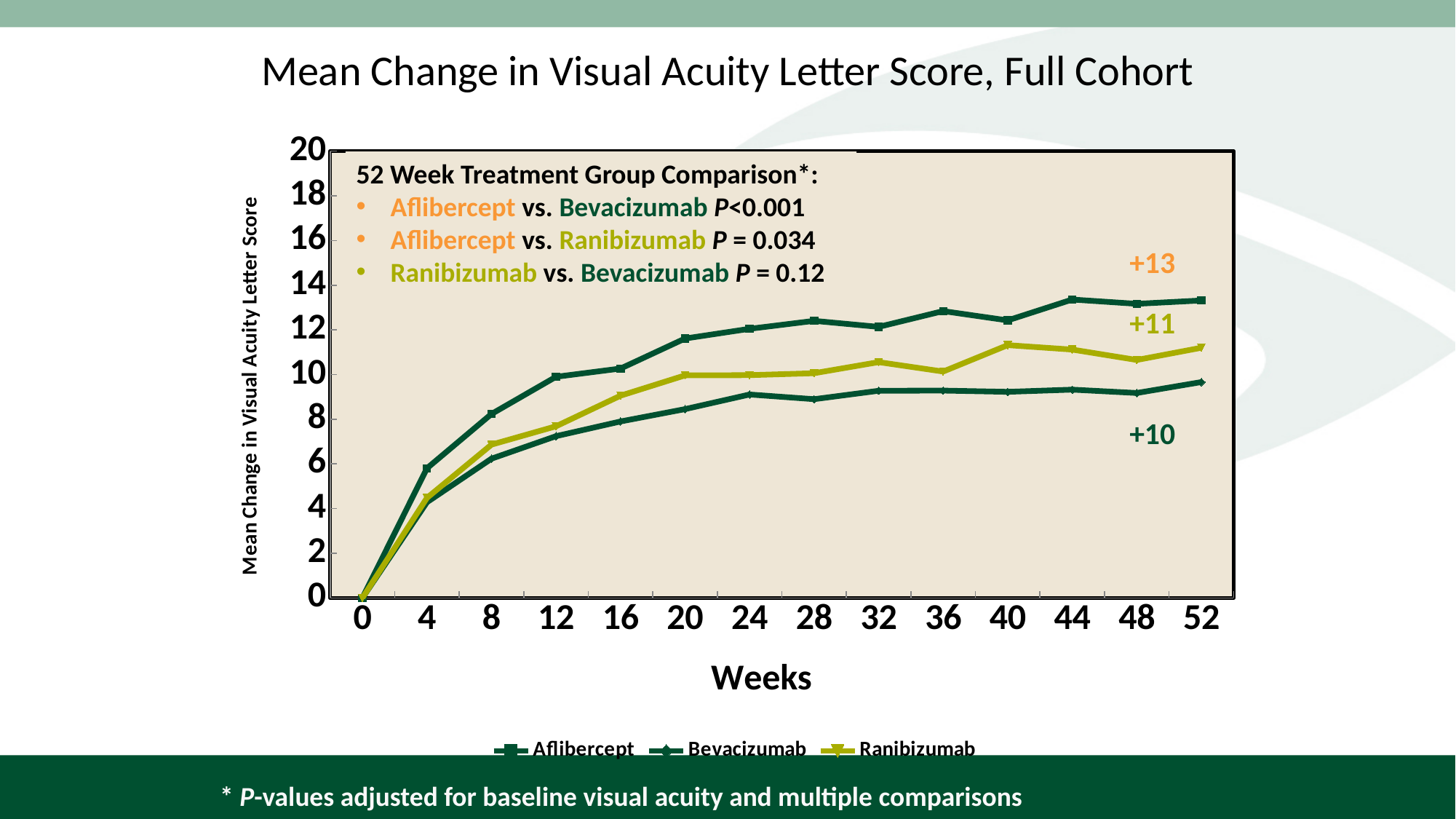
Which treatment group has the lowest mean change in visual acuity letter score at week 52? Bevacizumab Which treatment group has the highest mean change in visual acuity letter score at week 52? Aflibercept What type of chart is shown on the slide? line chart How many time points are shown along the x axis? 14 What is the mean change in visual acuity letter score for Ranibizumab at week 52? +11 What is the difference between the week 52 values for Aflibercept and Bevacizumab? 3 At week 52, which is larger: the value for Ranibizumab or the value for Bevacizumab? Ranibizumab Do the values for Aflibercept generally rise or fall from week 0 to week 52? rise Is the value for Aflibercept at week 20 greater or less than 10? greater What is the mean change in visual acuity letter score for Aflibercept at week 52? +13 What is the mean change in visual acuity letter score for Bevacizumab at week 52? +10 How many series does the legend list? 3